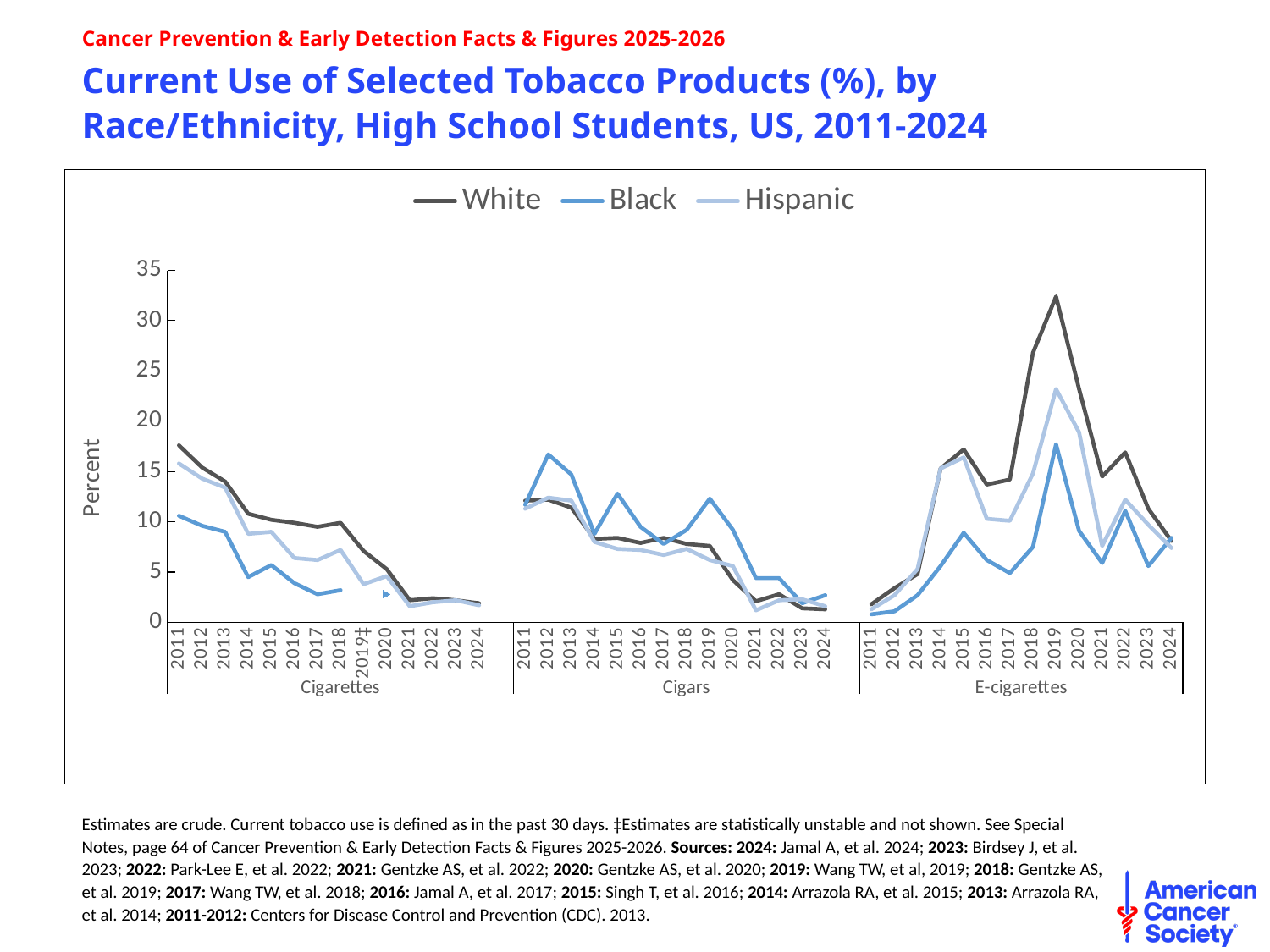
How many series does the legend list? 3 What is the label on the y axis? Percent How many tobacco product categories are shown along the x axis? 3 Is the value for White cigarette use in 2011 greater or less than 15? greater Which race/ethnicity group had the highest current cigar use in 2012? Black Is the value for Hispanic e-cigarette use in 2019 greater or less than 20? greater Which is larger, White or Black cigarette use in 2011? White Which three race/ethnicity groups are listed in the legend? White, Black, Hispanic Which race/ethnicity group had the highest current e-cigarette use in 2019? White What kind of chart is shown on the slide? line chart Does White cigarette use rise or fall from 2011 to 2024? fall Is the value for White e-cigarette use in 2019 greater or less than 30? greater